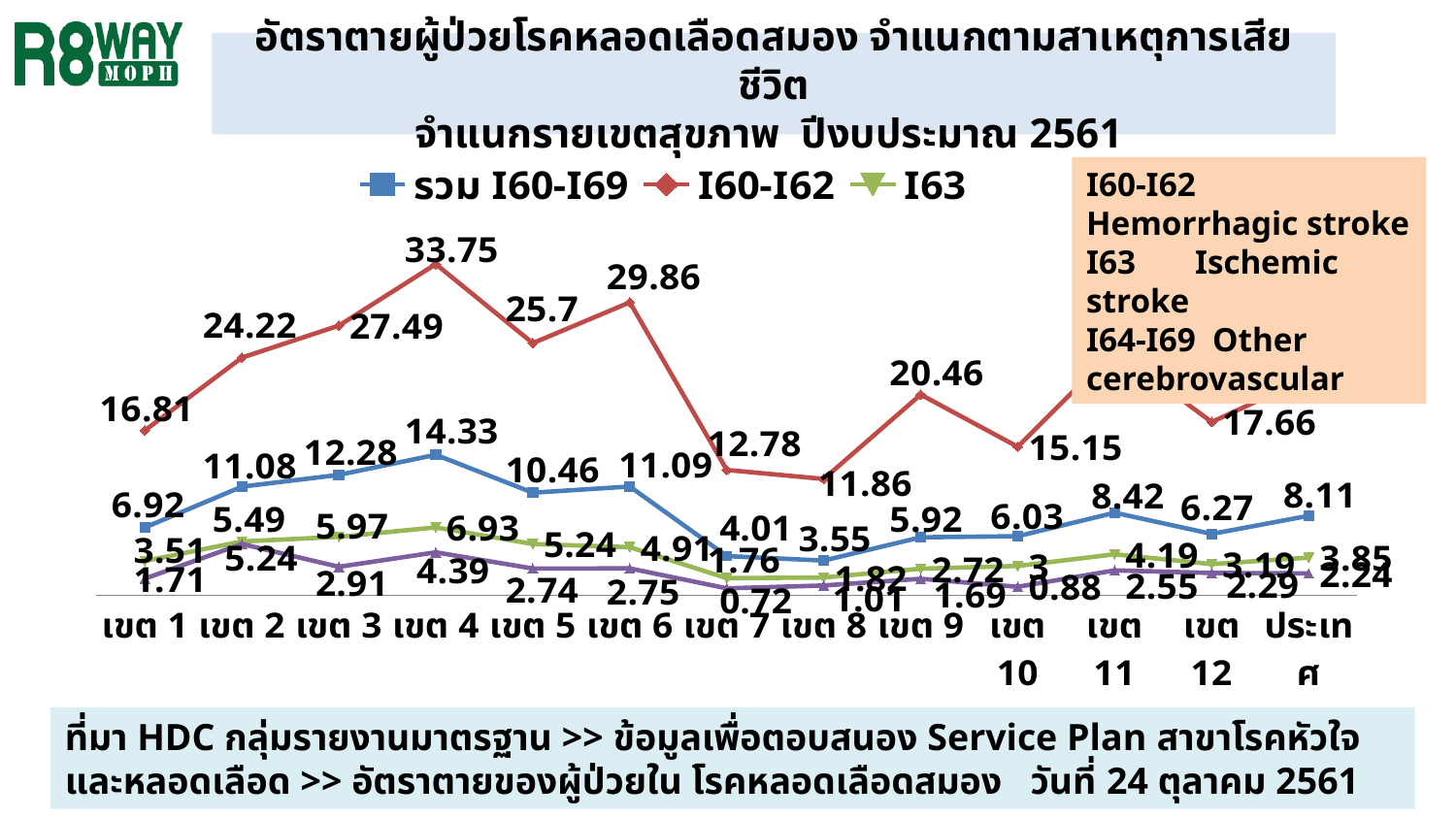
Which category has the lowest value for the I63 series? เขต 7 What type of chart is shown on the slide? line chart What is the value of the รวม I60-I69 series for ประเทศ? 8.11 How many series are listed in the legend? 3 Which category has the highest value for the รวม I60-I69 series? เขต 4 Which category has the lowest value for the รวม I60-I69 series? เขต 8 What is the value of the I60-I62 series for เขต 4? 33.75 Which is larger for the I60-I62 series: เขต 5 or เขต 6? เขต 6 What is the value of the I63 series for เขต 9? 2.72 What is the difference between the รวม I60-I69 values for เขต 4 and เขต 1? 7.41 How many categories are shown on the x axis? 13 Does the รวม I60-I69 series rise or fall from เขต 1 to เขต 4? rise